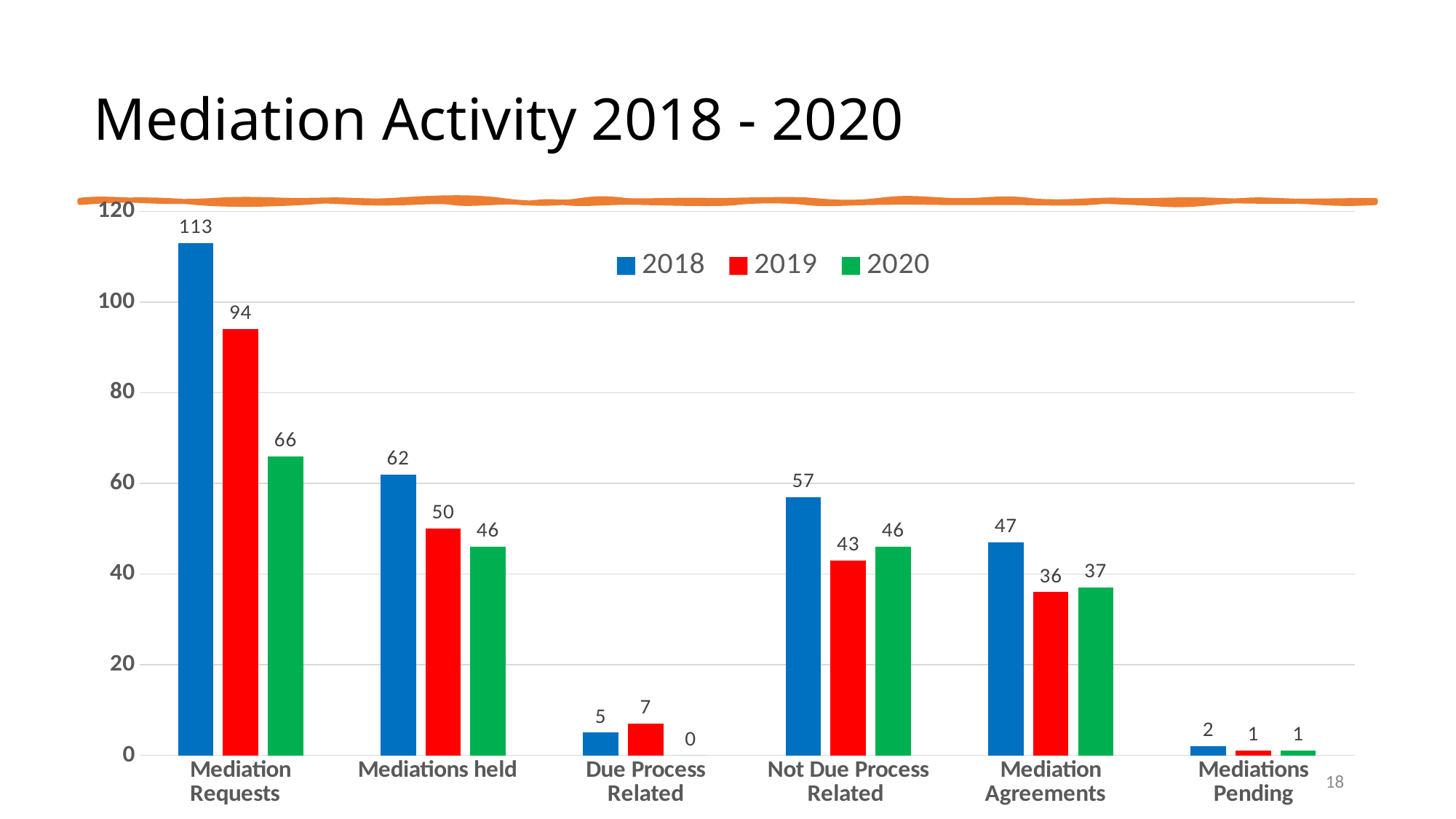
Which is larger: Not Due Process Related in 2019 or in 2020? 2020 Which category has the lowest value for 2020? Due Process Related Do the values for Mediation Requests rise or fall from 2018 to 2020? Fall What was the number of Mediation Requests in 2018? 113 What kind of chart is shown on the slide? Bar chart How many Mediations were held in 2020? 46 Which category has the highest value for 2019? Mediation Requests What is the difference between Mediation Requests in 2018 and 2020? 47 What is the 2019 value for Mediation Agreements? 36 How many series does the legend list? 3 Which colour represents the 2020 series in the legend? Green How many categories are shown on the x axis? 6